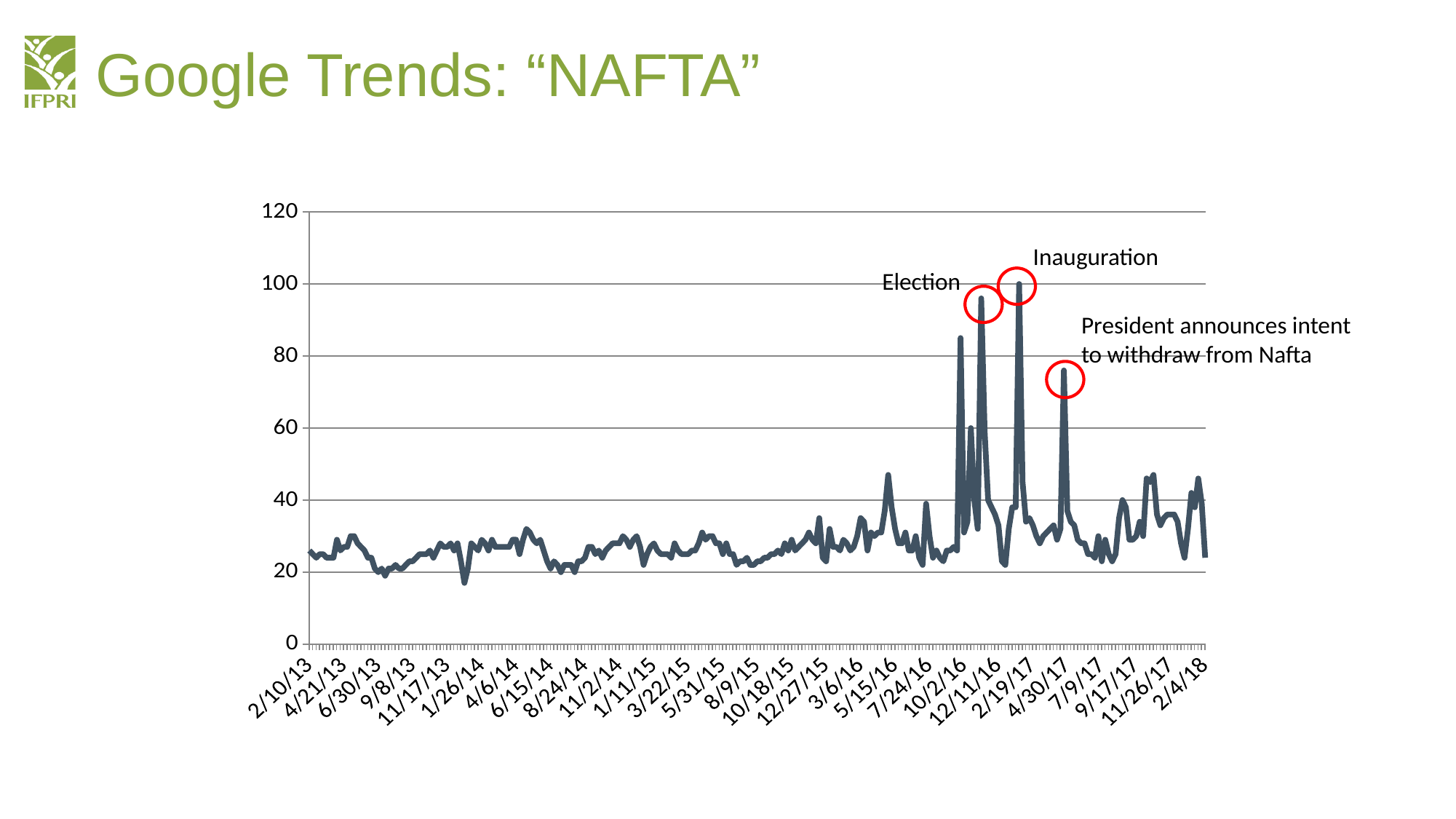
Is the peak labelled "Election" greater or less than 80? greater How many events are circled in red on the chart? 3 Which annotated event corresponds to the highest peak on the chart? Inauguration What is the maximum value shown on the y axis? 120 What value does the peak labelled "Inauguration" reach on the y axis? 100 Is the value at the first date, 2/10/13, greater or less than 40? less Which peak is higher, the one labelled "Election" or the one labelled "President announces intent to withdraw from Nafta"? Election What kind of chart is shown on the slide? line chart What is the title of the slide containing the chart? Google Trends: "NAFTA" Is the peak labelled "President announces intent to withdraw from Nafta" greater or less than 80? less Does the level of search interest in the period after 10/2/16 generally sit higher or lower than in the period before 5/15/16? higher